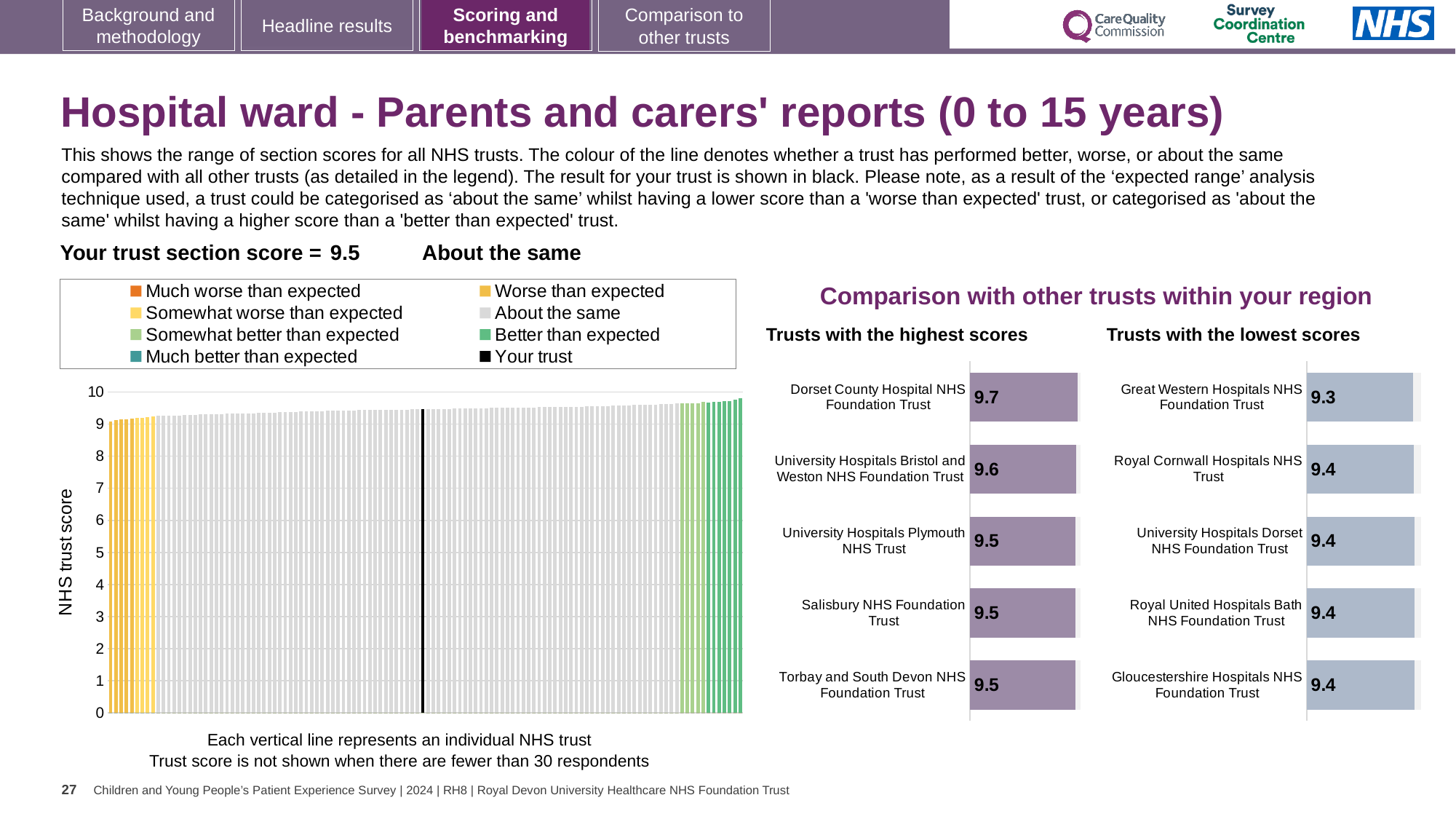
How many entries does the legend of the large 'NHS trust score' chart list? 8 In the 'Trusts with the lowest scores' chart, which trust has the lowest score? Great Western Hospitals NHS Foundation Trust In the 'Trusts with the highest scores' chart, which trust has the highest score? Dorset County Hospital NHS Foundation Trust In the large 'NHS trust score' chart, is the value for the black 'Your trust' bar greater or less than 9? greater In the 'Trusts with the lowest scores' chart, what is the score for Royal Cornwall Hospitals NHS Trust? 9.4 In the 'Trusts with the highest scores' chart, what is the difference between the scores of Dorset County Hospital NHS Foundation Trust and Salisbury NHS Foundation Trust? 0.2 How many trusts are listed in the 'Trusts with the highest scores' chart? 5 In the 'Trusts with the highest scores' chart, what is the score for Dorset County Hospital NHS Foundation Trust? 9.7 Which is larger: the score for Dorset County Hospital NHS Foundation Trust in the 'highest scores' chart or the score for Great Western Hospitals NHS Foundation Trust in the 'lowest scores' chart? Dorset County Hospital NHS Foundation Trust In the 'Trusts with the lowest scores' chart, what is the score for Great Western Hospitals NHS Foundation Trust? 9.3 In the 'Trusts with the highest scores' chart, what is the score for University Hospitals Bristol and Weston NHS Foundation Trust? 9.6 What kind of chart is the large chart with the 'NHS trust score' axis? Bar chart